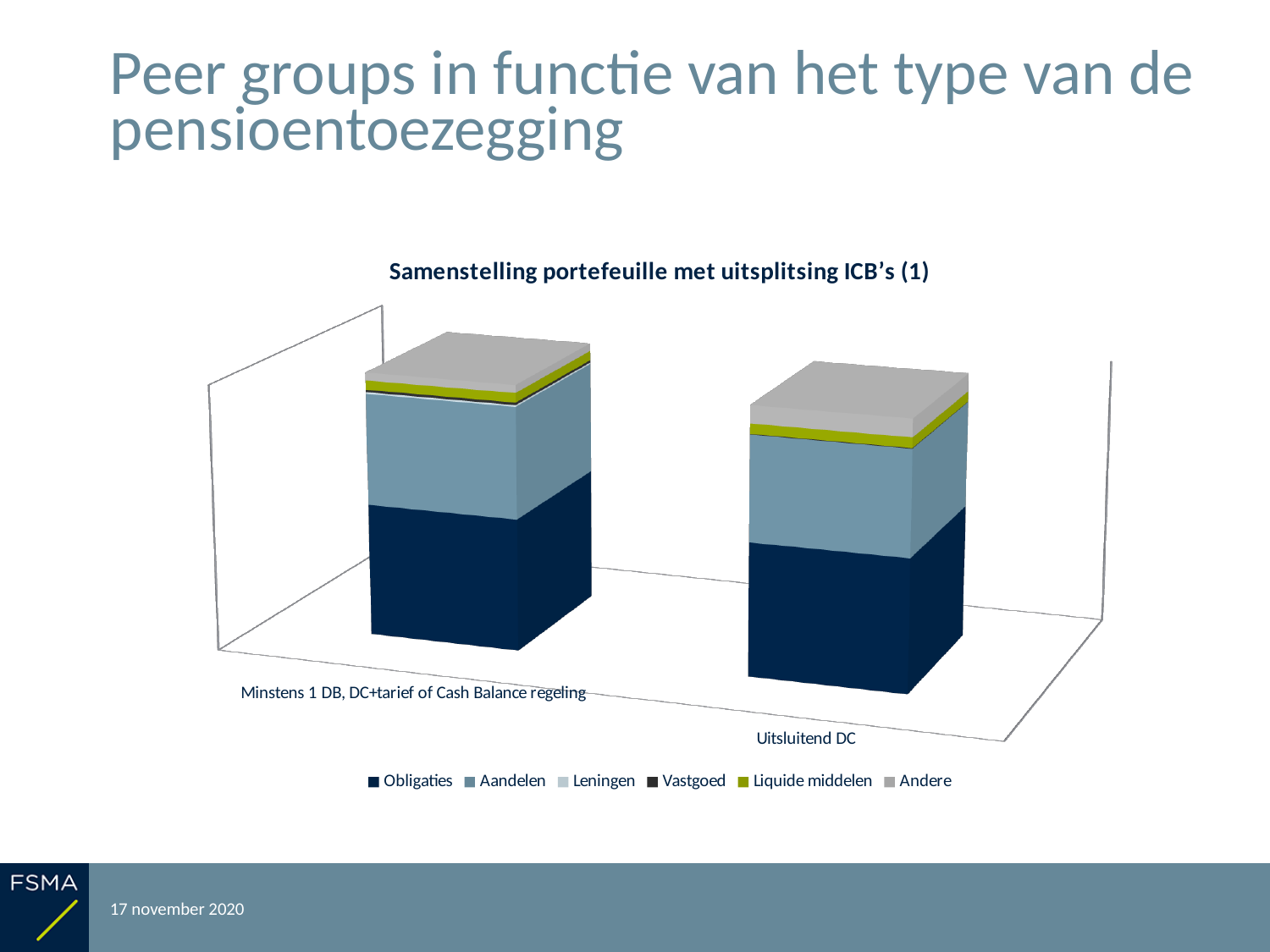
What is the title of the chart? Samenstelling portefeuille met uitsplitsing ICB's (1) How many series does the legend list? 6 In the bar for 'Uitsluitend DC', which segment is larger: Andere or Liquide middelen? Andere What kind of chart is shown on the slide? Stacked bar chart Which series is listed first in the legend? Obligaties In the bar for 'Minstens 1 DB, DC+tarief of Cash Balance regeling', which segment is larger: Obligaties or Aandelen? Obligaties Which series forms the bottom segment of each stacked bar? Obligaties How many categories (bars) are shown in the chart? 2 In the bar for 'Uitsluitend DC', which segment is larger: Obligaties or Aandelen? Obligaties